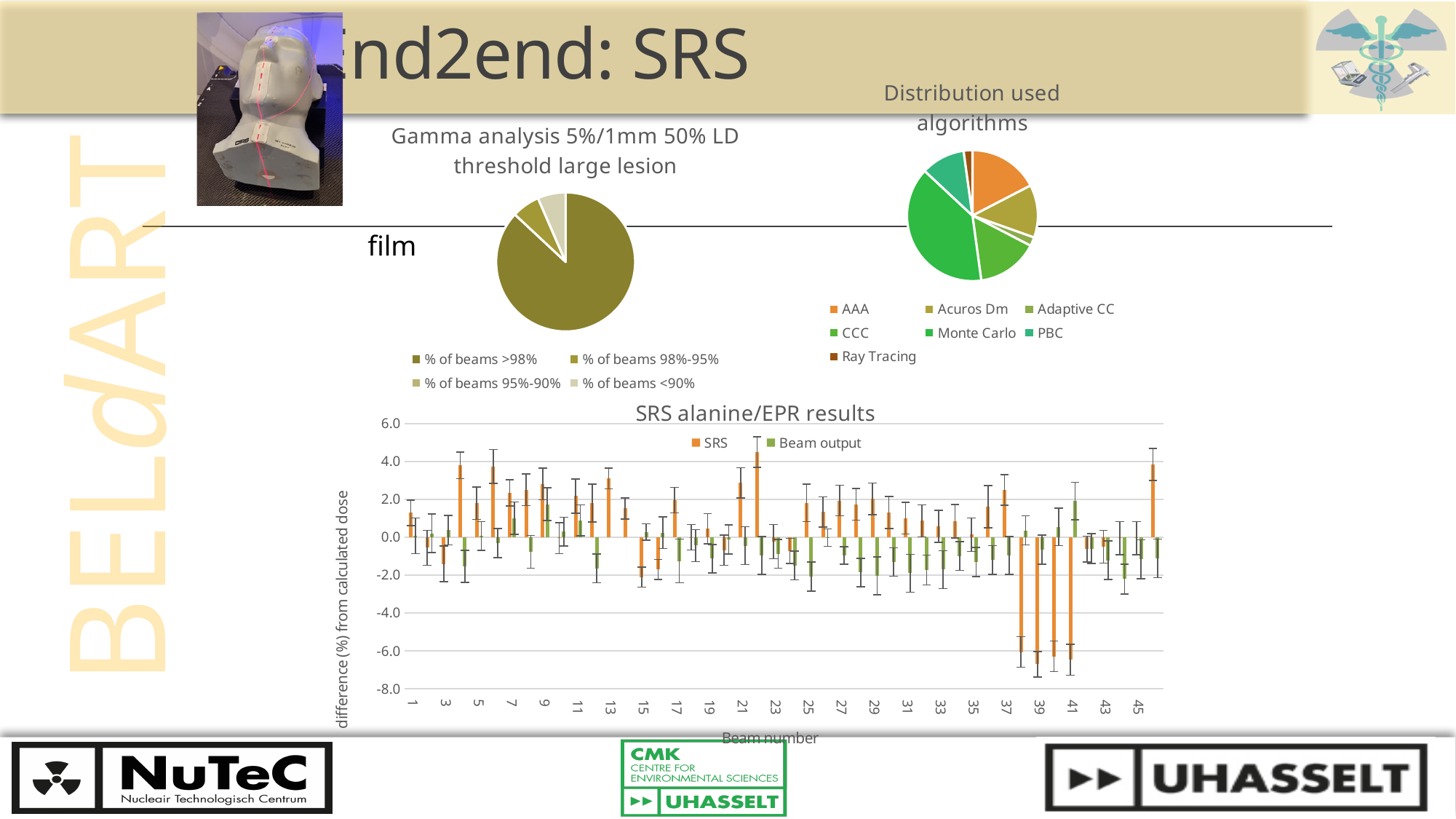
What kind of chart is the 'Distribution used algorithms' chart? pie chart How many algorithms does the legend of the 'Distribution used algorithms' pie chart list? 7 What kind of chart is the 'SRS alanine/EPR results' chart? bar chart What kind of chart is the 'Gamma analysis 5%/1mm 50% LD threshold large lesion' chart? pie chart In the 'Gamma analysis 5%/1mm 50% LD threshold large lesion' pie chart, which category has the largest slice? % of beams >98% How many categories does the legend of the 'Gamma analysis 5%/1mm 50% LD threshold large lesion' pie chart list? 4 In the 'SRS alanine/EPR results' chart, is the SRS value for beam number 39 greater or less than -4.0? less In the 'SRS alanine/EPR results' chart, is the SRS value for beam number 22 greater or less than 4.0? greater How many series does the legend of the 'SRS alanine/EPR results' chart list? 2 In the 'Distribution used algorithms' pie chart, which algorithm has the largest slice? Monte Carlo What is the y-axis label of the 'SRS alanine/EPR results' chart? difference (%) from calculated dose